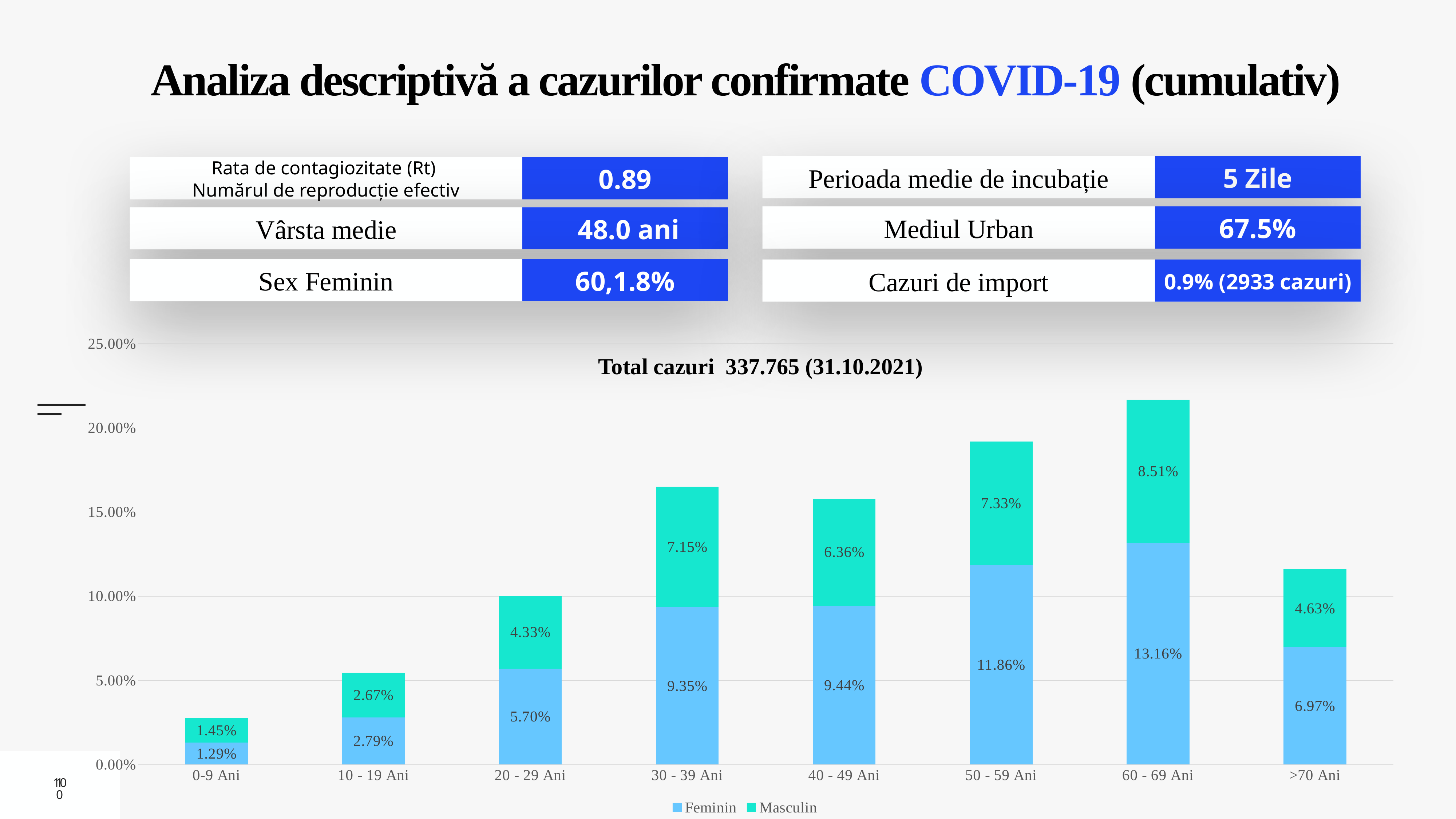
What is the total of the stacked bar for the 60 - 69 Ani age group? 21.67% What kind of chart is shown on the slide? Stacked bar chart Which age group has the highest Feminin value? 60 - 69 Ani Which is larger for the 0-9 Ani age group, the Feminin value or the Masculin value? Masculin Which age group has the lowest Masculin value? 0-9 Ani What is the difference between the Feminin and Masculin values for the 50 - 59 Ani age group? 4.53% How many series does the legend list? 2 What is the Feminin value for the 60 - 69 Ani age group? 13.16% What is the Masculin value for the 30 - 39 Ani age group? 7.15% Is the total stacked bar for the 60 - 69 Ani age group greater or less than 20.00%? greater What are the two series named in the chart legend? Feminin and Masculin How many age groups are shown on the x axis? 8